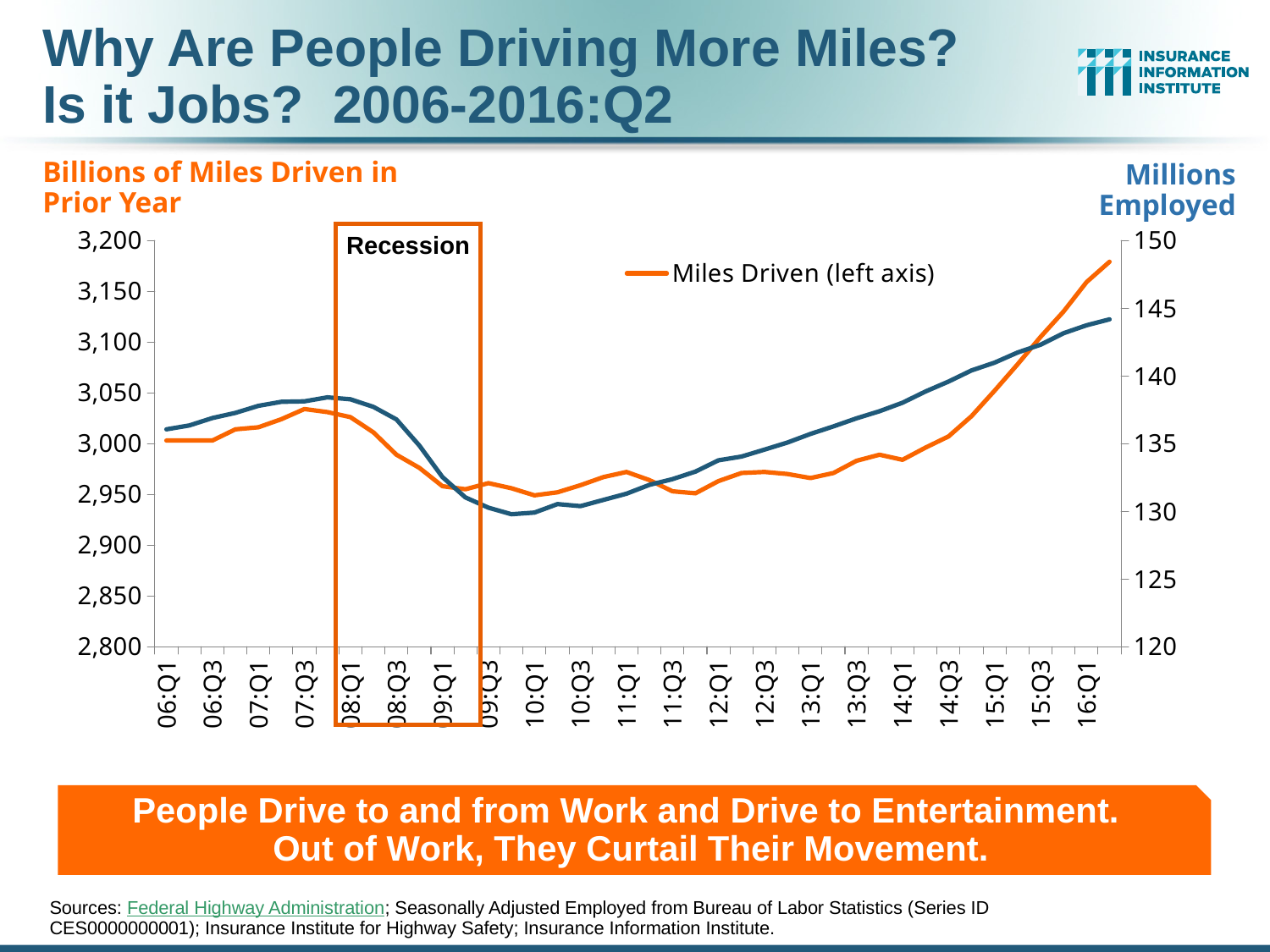
Is the highest value of the Miles Driven line at the start or the end of the period shown? end Is the value for Miles Driven at 09:Q1 greater or less than 3,000? less What kind of chart is shown on the slide? line chart What is the title of the right-hand axis? Millions Employed Which is larger for Miles Driven: the value at 16:Q1 or the value at 06:Q1? 16:Q1 Is the value for Miles Driven at 13:Q1 greater or less than 3,000? less Does the Miles Driven line rise or fall between 07:Q3 and 09:Q1? fall How many series does the chart's legend list? 1 Does the Miles Driven line rise or fall between 14:Q1 and 16:Q1? rise Is the value for Miles Driven at 06:Q1 greater or less than 3,050? less How many quarter labels are shown along the x axis? 21